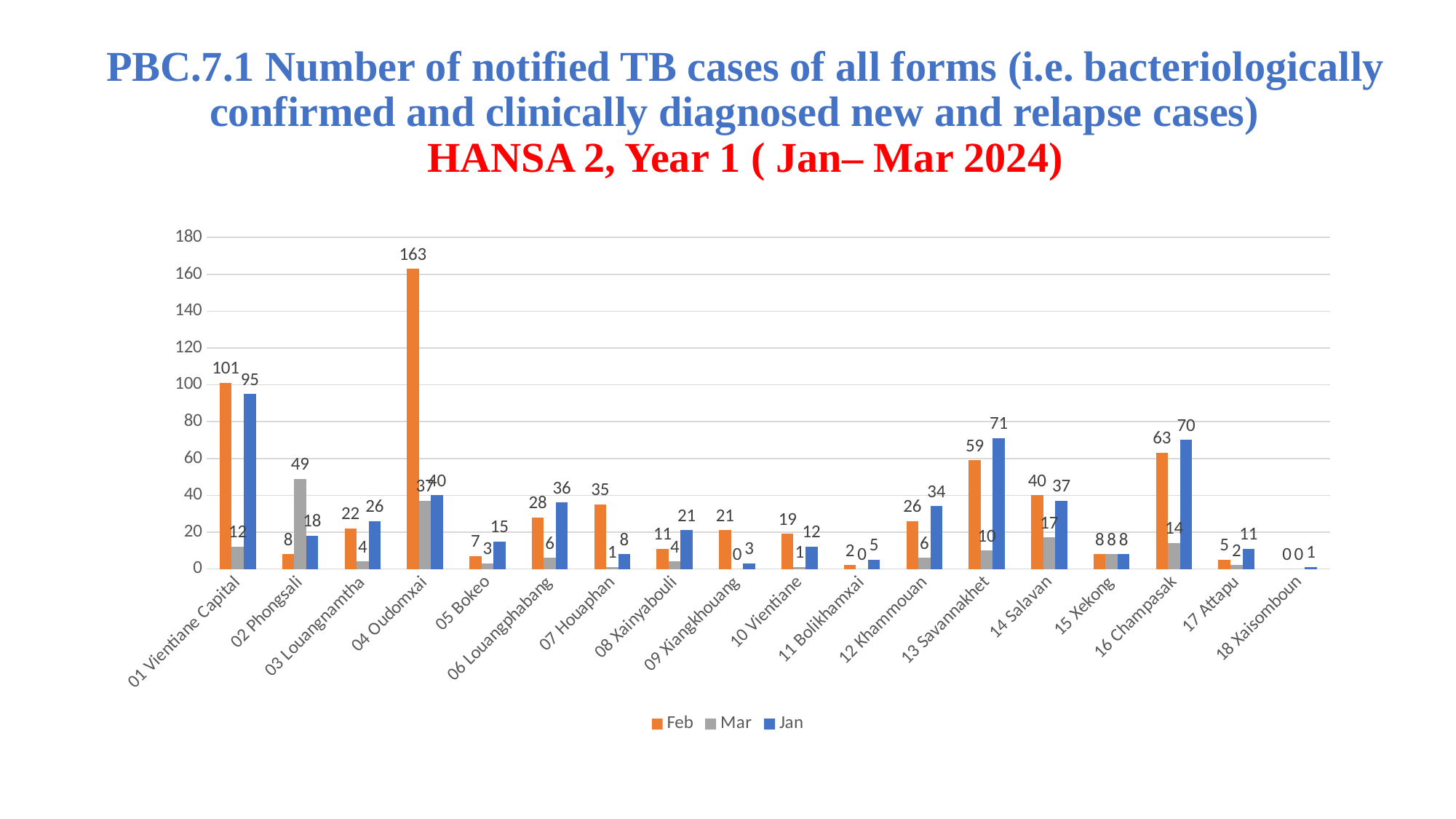
How many series does the legend list? 3 Which province has the lowest Jan value? 18 Xaisomboun What is the Jan value for 16 Champasak? 70 What is the Jan value for 13 Savannakhet? 71 What is the Mar value for 02 Phongsali? 49 Which province has the highest Feb value? 04 Oudomxai What is the Feb value for 04 Oudomxai? 163 Which is larger for 14 Salavan, the Feb value or the Jan value? Feb Which colour represents the Mar series in the legend? Gray What is the difference between the Feb and Jan values for 01 Vientiane Capital? 6 What kind of chart is shown on the slide? Bar chart How many provinces are shown on the x axis? 18